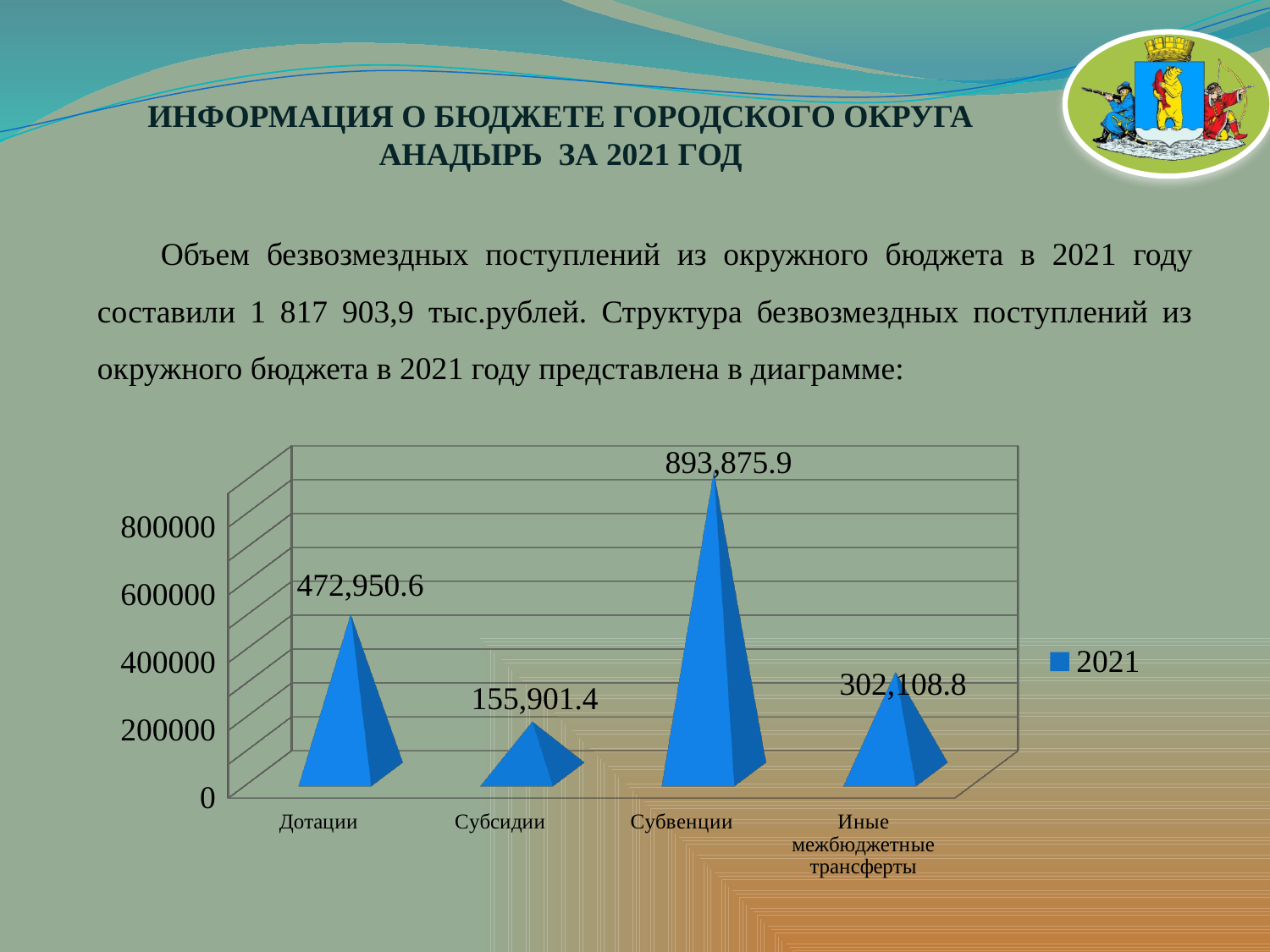
What is the difference between the values for Иные межбюджетные трансферты and Субсидии? 146,207.4 What is the value for Дотации? 472,950.6 What series does the legend list? 2021 What is the difference between the values for Субвенции and Дотации? 420,925.3 Which is larger, the value for Дотации or the value for Иные межбюджетные трансферты? Дотации How many categories are shown on the x axis? 4 Is the value for Субвенции greater or less than 800000? greater What is the value for Субсидии? 155,901.4 What is the value for Иные межбюджетные трансферты? 302,108.8 Which category has the lowest value? Субсидии What is the value for Субвенции? 893,875.9 Which category has the highest value? Субвенции